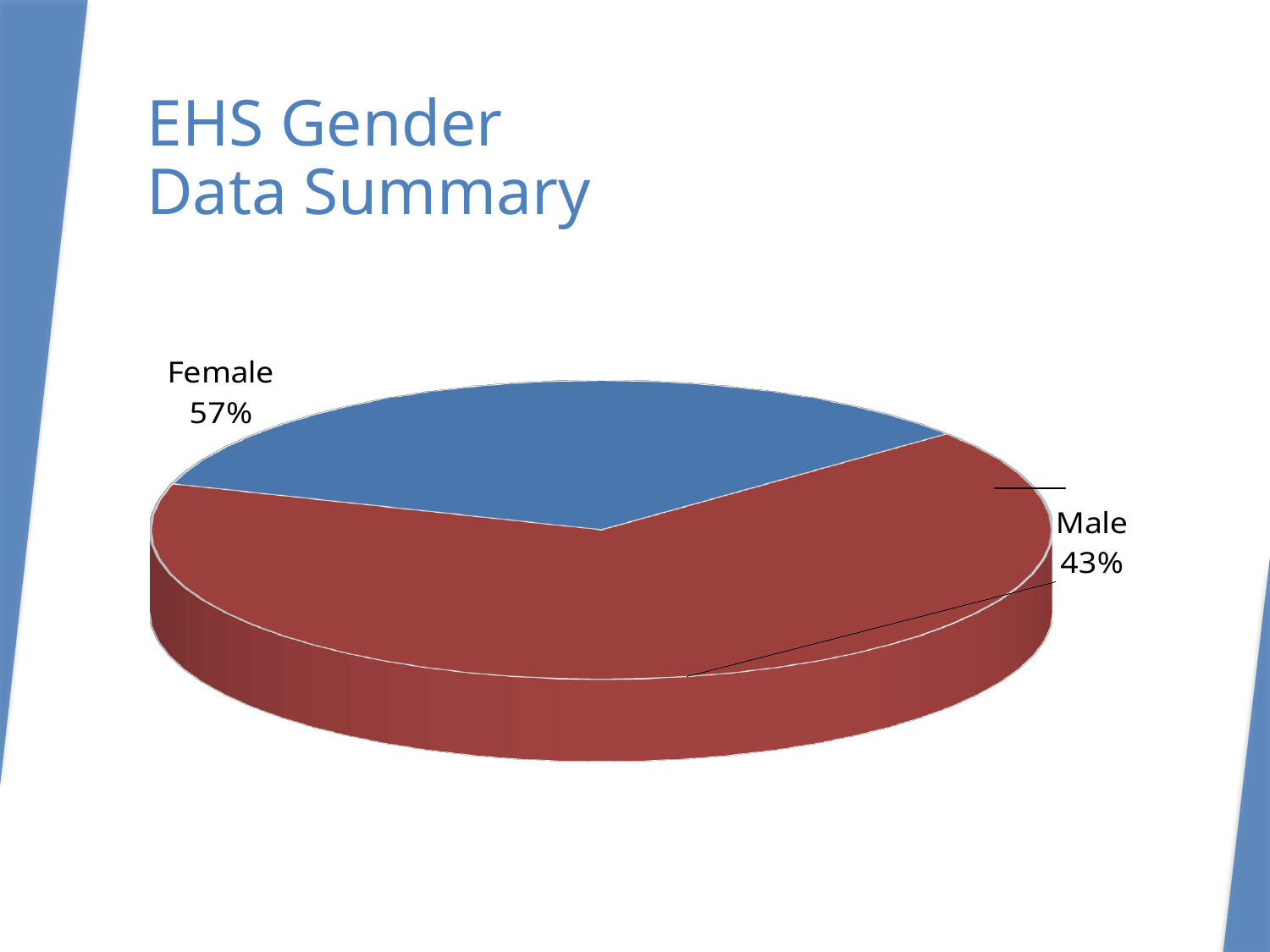
What colour is the Male slice in the pie chart? Red What is the difference in percentage points between the Female and Male slices? 14% What is the title of the slide containing the pie chart? EHS Gender Data Summary What percentage is shown for Male in the pie chart? 43% What percentage is shown for Female in the pie chart? 57% What share of the pie does the Male slice represent? 43% What kind of chart is shown on the slide? Pie chart How many categories are shown in the pie chart? 2